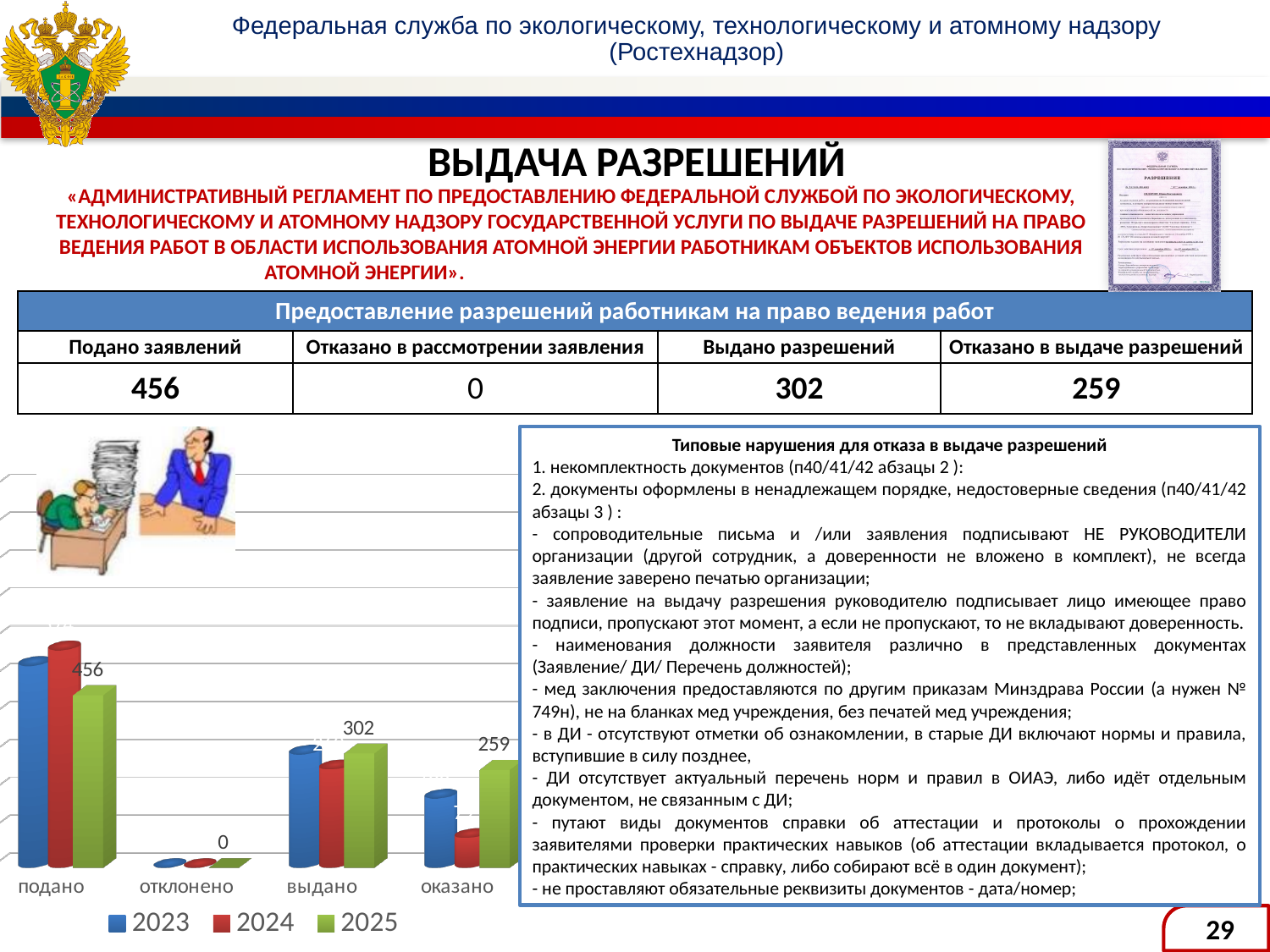
Among the 2025 values, which category is the highest? подано What is the value for 2025 in the оказано category? 259 Which category has the lowest values in the chart? отклонено How many series does the chart legend list? 3 For 2025, which is larger: выдано or оказано? выдано How many categories are shown on the x axis of the chart? 4 What is the difference between the 2025 values for подано and выдано? 154 What is the value for 2025 in the выдано category? 302 What is the value for 2025 in the подано category? 456 What kind of chart is shown on the slide? bar chart What value is labelled for the отклонено category? 0 Which colour represents the 2024 series in the chart? red